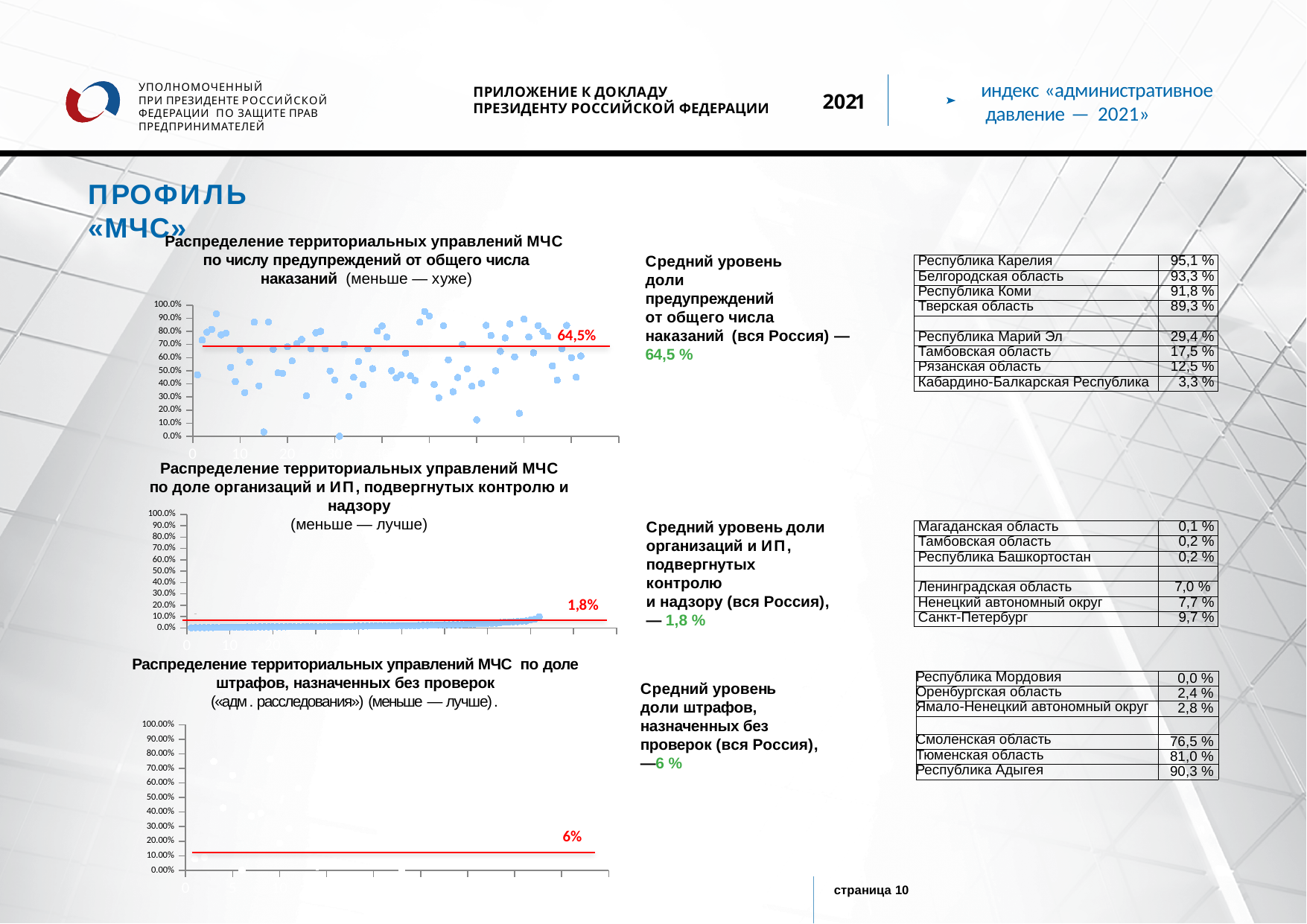
In the middle chart, do the plotted values rise or fall along the x axis? rise Which of the three charts has the highest labelled average-line value? the top chart (64,5%) In the middle chart (по доле организаций и ИП, подвергнутых контролю и надзору), what value is labelled on the red horizontal line? 1,8% How many charts are shown on the slide? 3 In the bottom chart (по доле штрафов, назначенных без проверок), what value is labelled on the red horizontal line? 6% In the middle chart, are the plotted points mostly above or below the 10.0% axis tick? below Is the red-line value in the bottom chart (по доле штрафов) larger or smaller than the red-line value in the middle chart (по доле организаций и ИП)? larger What kind of chart is the top chart, 'Распределение территориальных управлений МЧС по числу предупреждений от общего числа наказаний'? scatter chart What colour is the horizontal average line drawn in each chart? red What is the difference between the red-line value in the top chart (64,5%) and the red-line value in the bottom chart (6%)? 58,5% In the top chart (по числу предупреждений), what value is labelled on the red horizontal line? 64,5% Which of the three charts has the lowest labelled average-line value? the middle chart (1,8%)